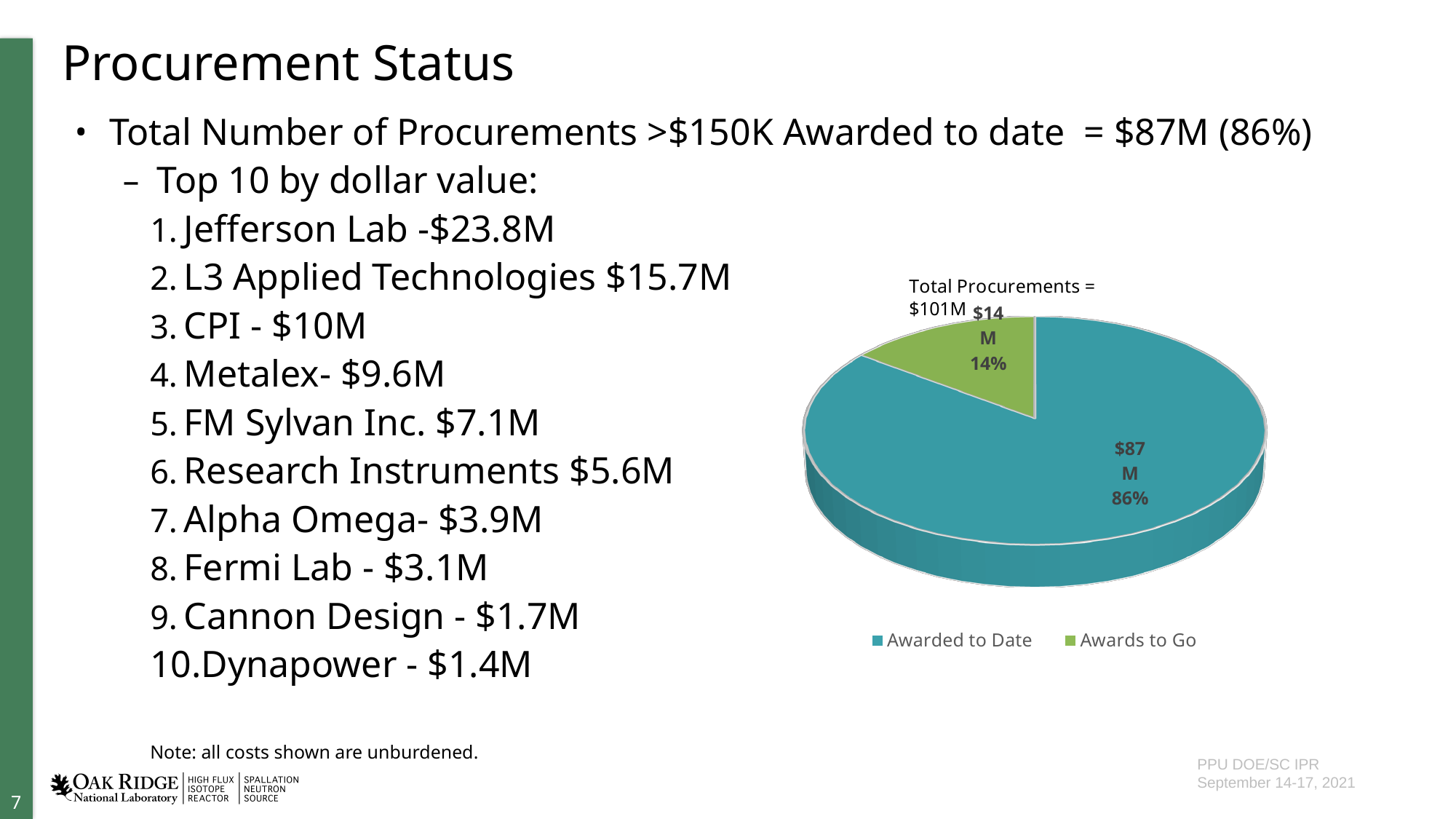
How many entries does the legend of the pie chart list? 2 What share of the pie does Awards to Go represent? 14% What is the value for Awarded to Date in the pie chart? $87M What is the difference in dollar value between Awarded to Date and Awards to Go? $73M What total is stated in the label above the pie chart? Total Procurements = $101M Which slice of the pie chart is the largest? Awarded to Date What kind of chart is shown on the slide? pie chart How many slices does the pie chart have? 2 Which slice of the pie chart is the smallest? Awards to Go What share of the pie does Awarded to Date represent? 86% Which is larger, Awarded to Date or Awards to Go? Awarded to Date What is the value for Awards to Go in the pie chart? $14M